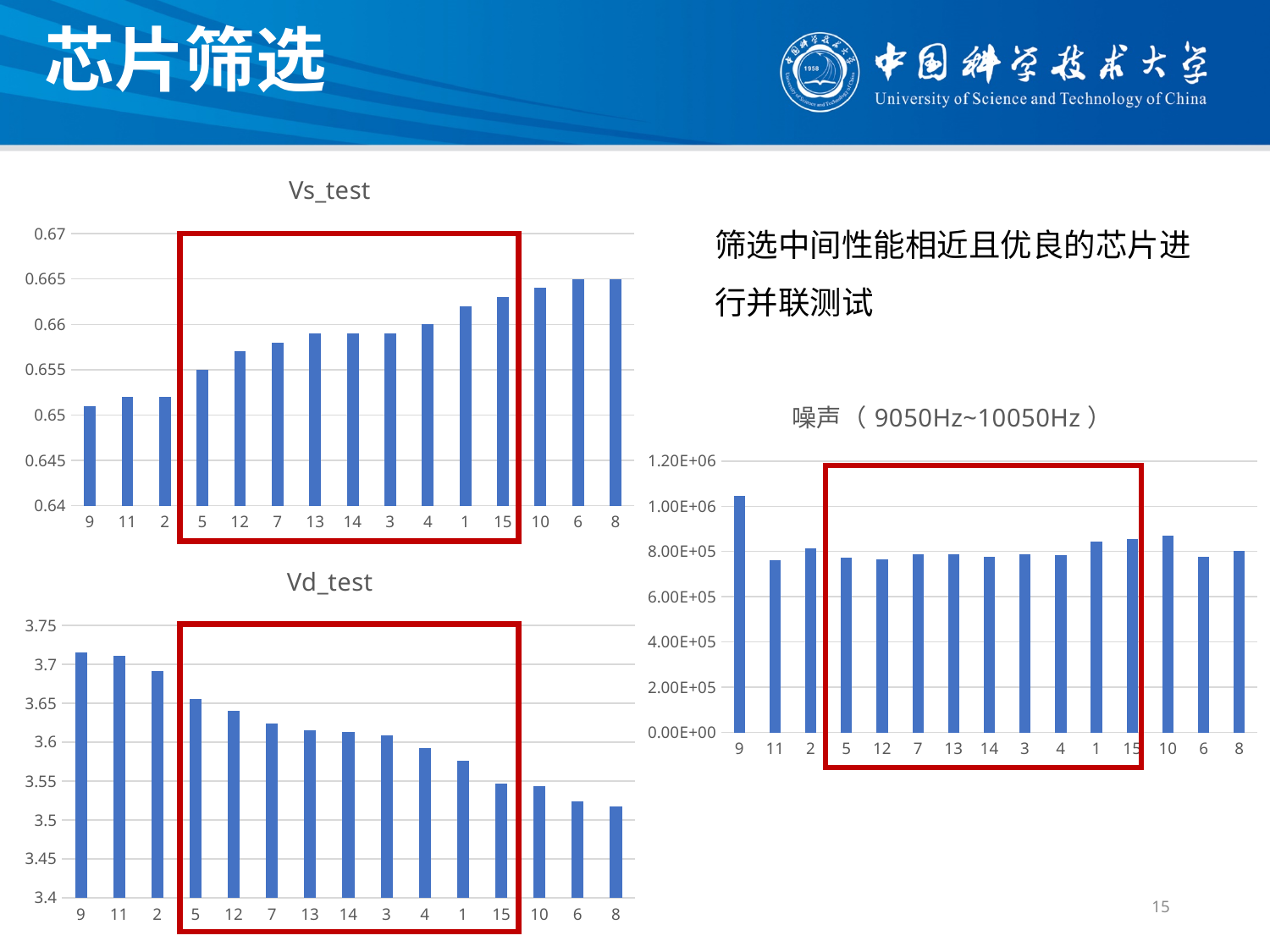
In the 噪声（9050Hz~10050Hz）chart, which category has the highest value? 9 In the Vs_test chart, which category has the lowest value? 9 In the Vs_test chart, do the values generally rise or fall from left to right along the x axis? rise In the Vs_test chart, which is larger, the value for category 9 or the value for category 8? 8 In the Vd_test chart, is the value for category 9 greater or less than 3.7? greater In the Vs_test chart, is the value for category 9 greater or less than 0.655? less What is the title of the chart on the right side of the slide? 噪声（9050Hz~10050Hz） In the Vd_test chart, is the value for category 8 greater or less than 3.55? less What type of chart is the Vs_test chart? bar chart How many categories are shown on the x axis of the Vd_test chart? 15 In the Vd_test chart, do the values generally rise or fall from left to right along the x axis? fall